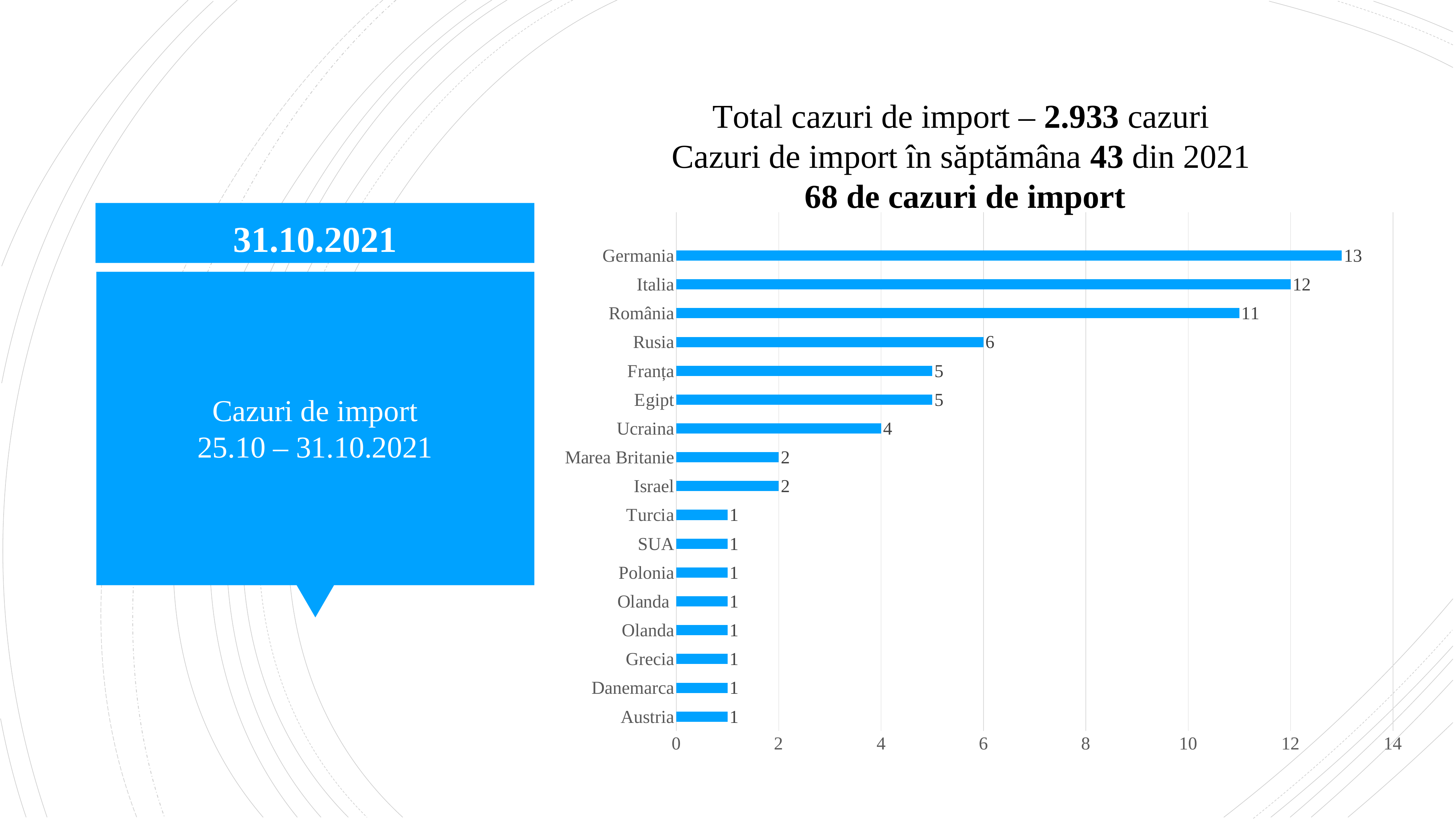
What is the difference between the values for Germania and România? 2 What is the value for Germania? 13 Which is larger, the value for Franța or the value for Ucraina? Franța What is the value for Marea Britanie? 2 What is the value for Ucraina? 4 What is the value for România? 11 What kind of chart is shown on the slide? bar chart Which country has the highest value? Germania How many bars are plotted in the chart? 17 What is the highest tick value shown on the horizontal axis? 14 What is the difference between the values for Italia and Rusia? 6 What is the value for Rusia? 6